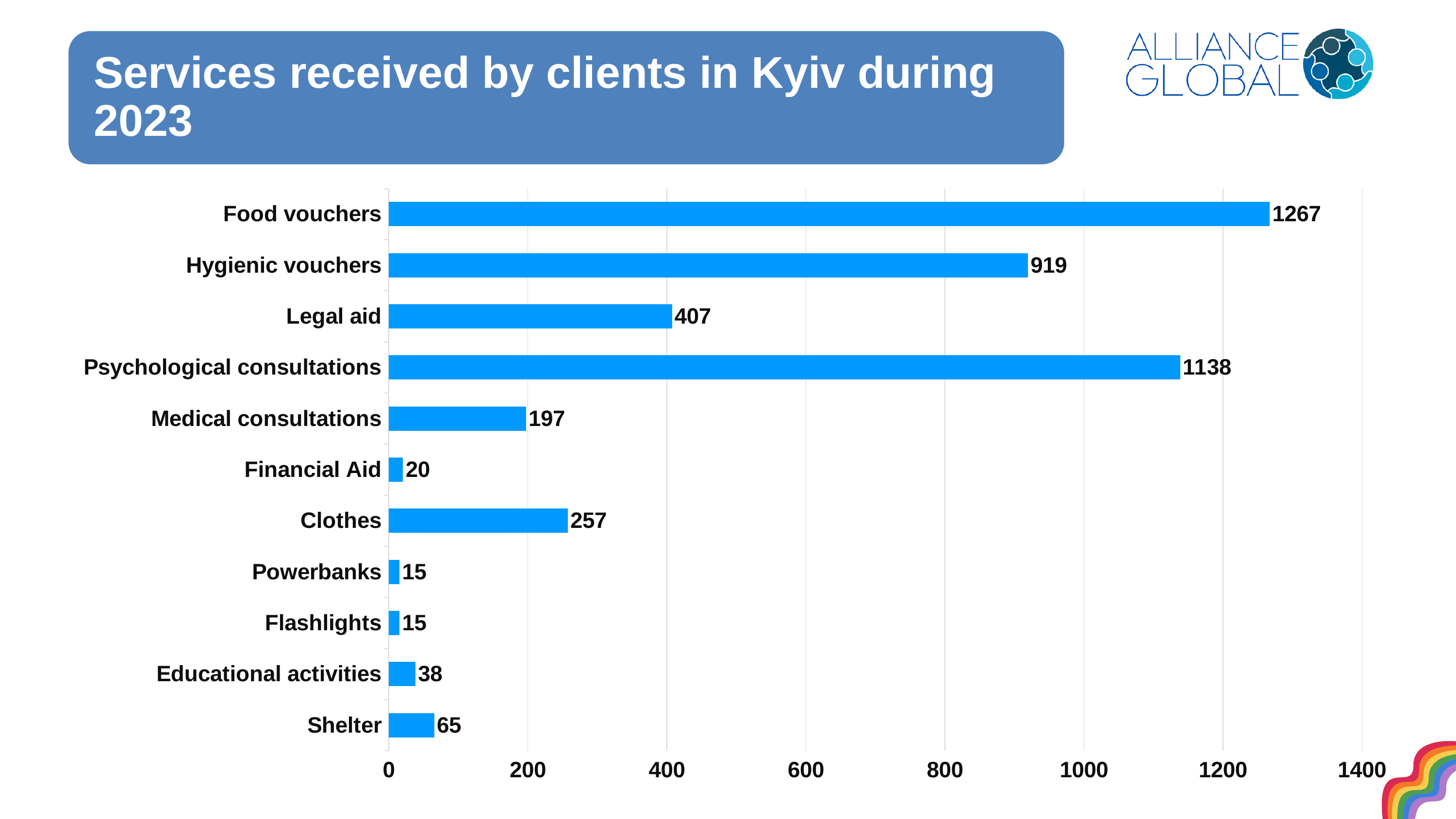
What kind of chart is shown on the slide? Bar chart What is the value for Medical consultations? 197 How many categories are shown on the chart? 11 What is the title of the slide? Services received by clients in Kyiv during 2023 What is the difference between Food vouchers and Psychological consultations? 129 Which category has the lowest value, Financial Aid or Shelter? Financial Aid Is the value for Legal aid greater or less than 400? greater Which category has the highest value? Food vouchers Which is larger, Clothes or Medical consultations? Clothes What is the difference between Hygienic vouchers and Legal aid? 512 What is the value for Psychological consultations? 1138 What is the value for Food vouchers? 1267